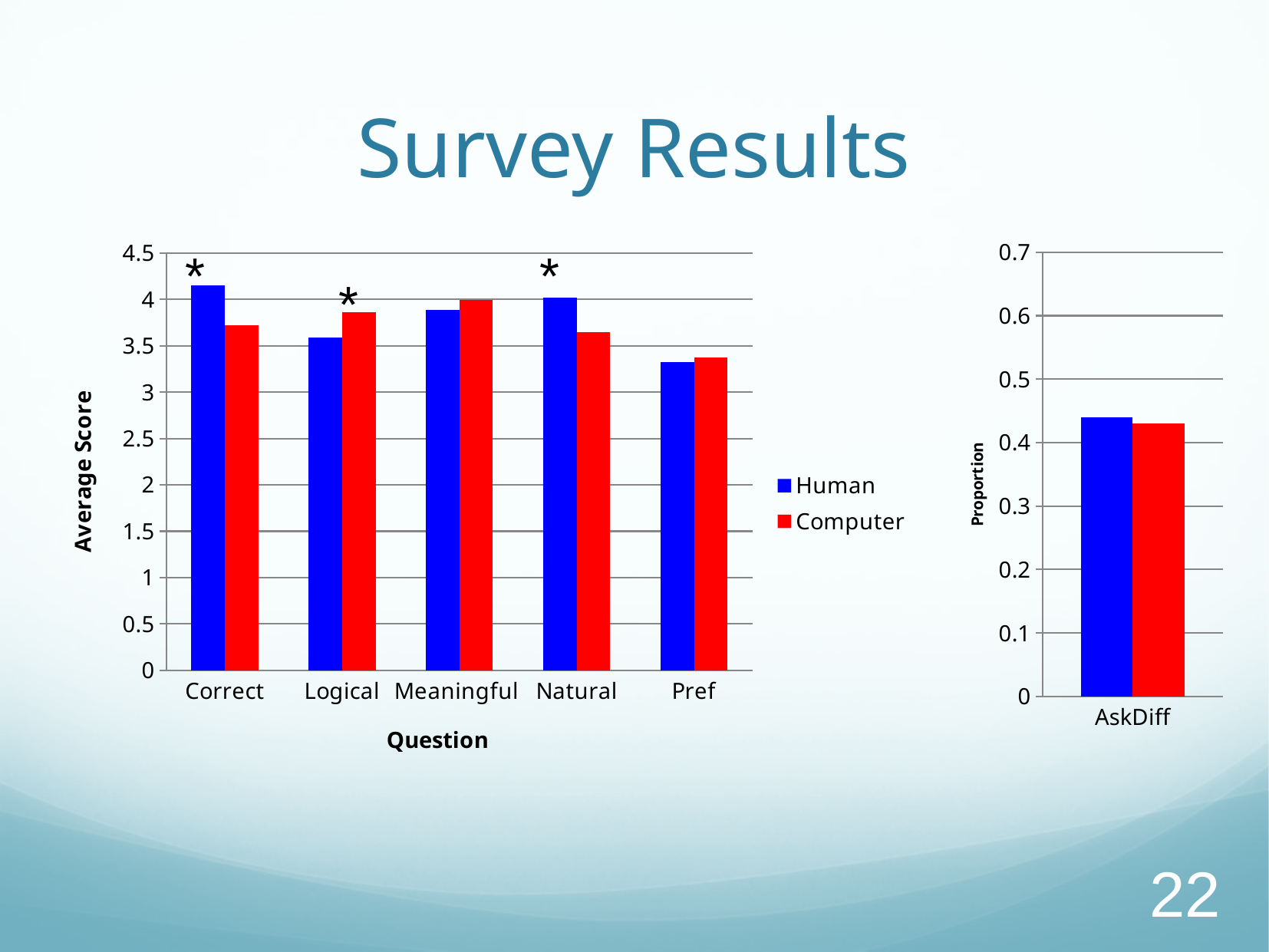
On the left chart, for the Natural question, which is larger: the Human score or the Computer score? Human On the left chart, for the Logical question, which is larger: the Human score or the Computer score? Computer On the left chart, which question has the highest Human score? Correct On the left chart, which question has the lowest Human score? Pref On the left chart, how many questions are shown on the x axis? 5 On the right chart, is the value of the blue bar for AskDiff greater or less than 0.5? less On the left chart, is the Human score for Pref greater or less than 3.5? less On the left chart, how many series does the legend list? 2 On the left chart, is the Human score for Correct greater or less than 4? greater On the left chart, which question has the lowest Computer score? Pref On the left chart, what kind of chart is shown? bar chart